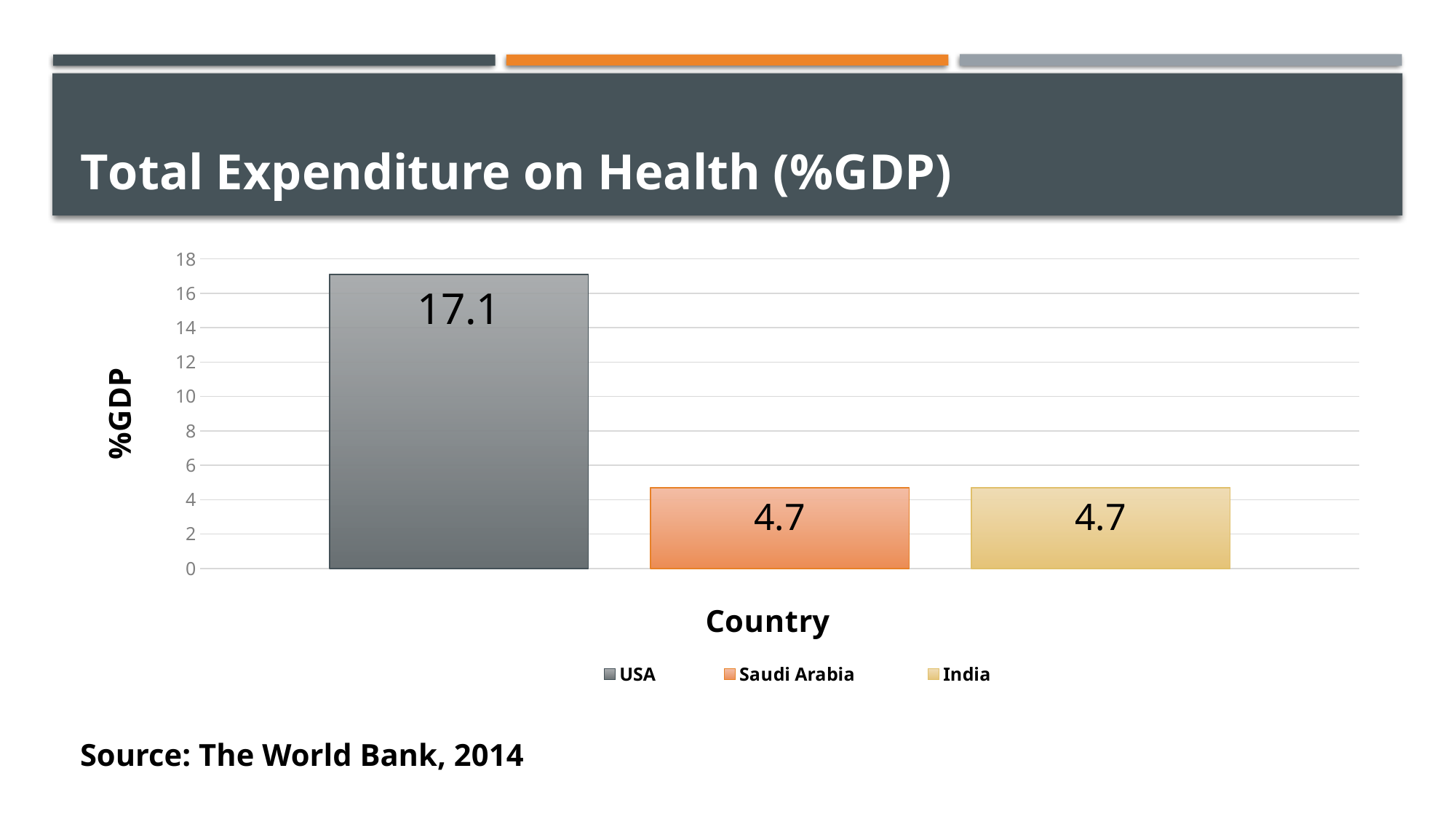
What is the total expenditure on health (%GDP) for Saudi Arabia? 4.7 Is the value for the USA greater or less than 16? greater Which is larger, the health expenditure (%GDP) of the USA or of Saudi Arabia? USA What is the label of the vertical axis? %GDP Is the value for Saudi Arabia greater or less than 6? less How many countries are shown in the chart? 3 What is the total expenditure on health (%GDP) for India? 4.7 What kind of chart is shown on the slide? Bar chart What is the difference between the USA's and India's health expenditure (%GDP)? 12.4 Which country has the highest total expenditure on health as a percentage of GDP? USA What is the total expenditure on health (%GDP) for the USA? 17.1 How many entries does the legend list? 3